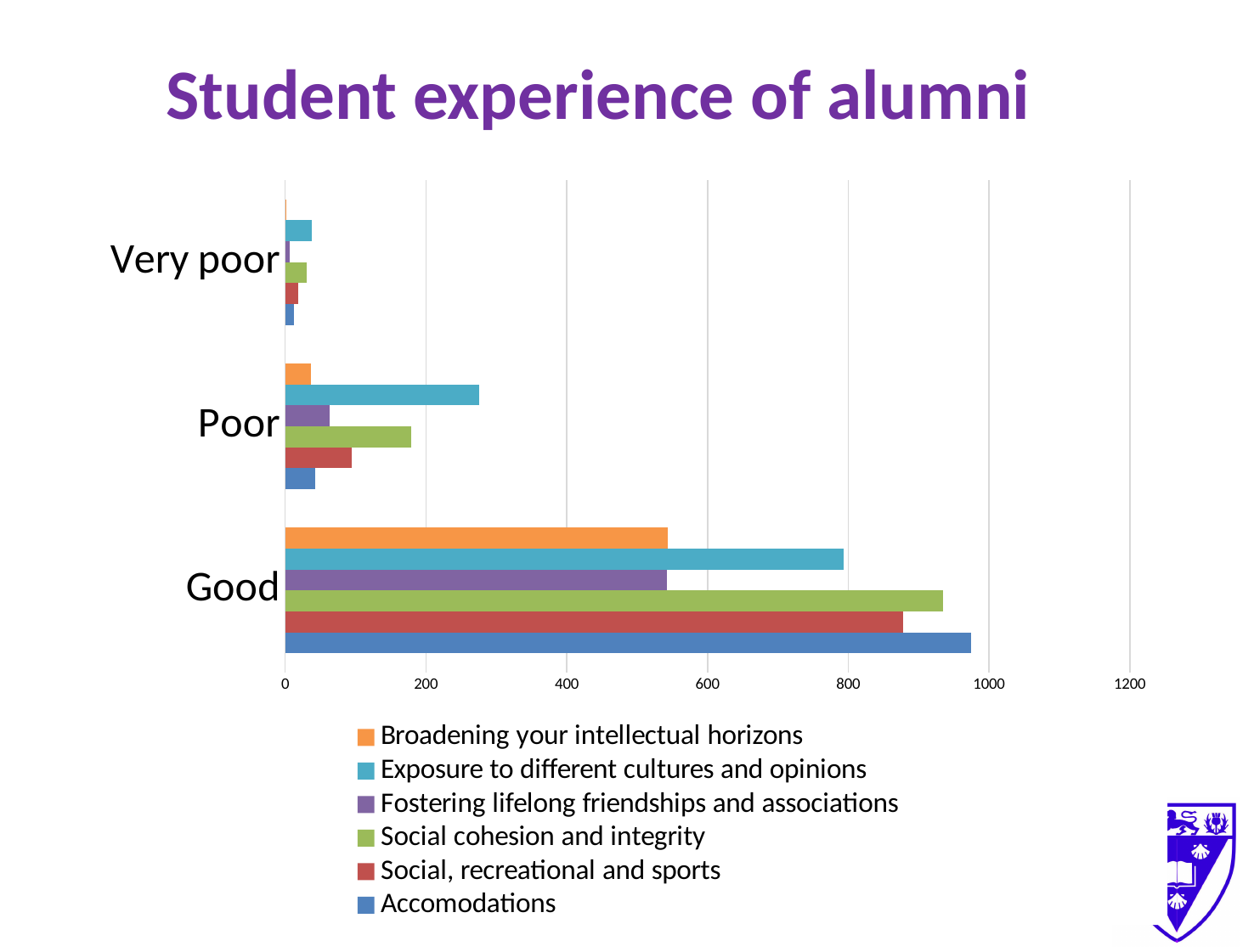
How many categories are shown on the vertical axis of the chart? 3 Which series has the longest bar in the Poor category? Exposure to different cultures and opinions In the Poor category, which is larger: Social cohesion and integrity or Social, recreational and sports? Social cohesion and integrity What is the title of the slide? Student experience of alumni What kind of chart is shown on the slide? Bar chart In the Good category, which is larger: Social cohesion and integrity or Social, recreational and sports? Social cohesion and integrity Is the value for Exposure to different cultures and opinions in the Good category greater or less than 600? greater How many series does the legend list? 6 Which series has the longest bar in the Good category? Accomodations Is the value for Social cohesion and integrity in the Poor category greater or less than 200? less Is the value for Exposure to different cultures and opinions in the Poor category greater or less than 200? greater